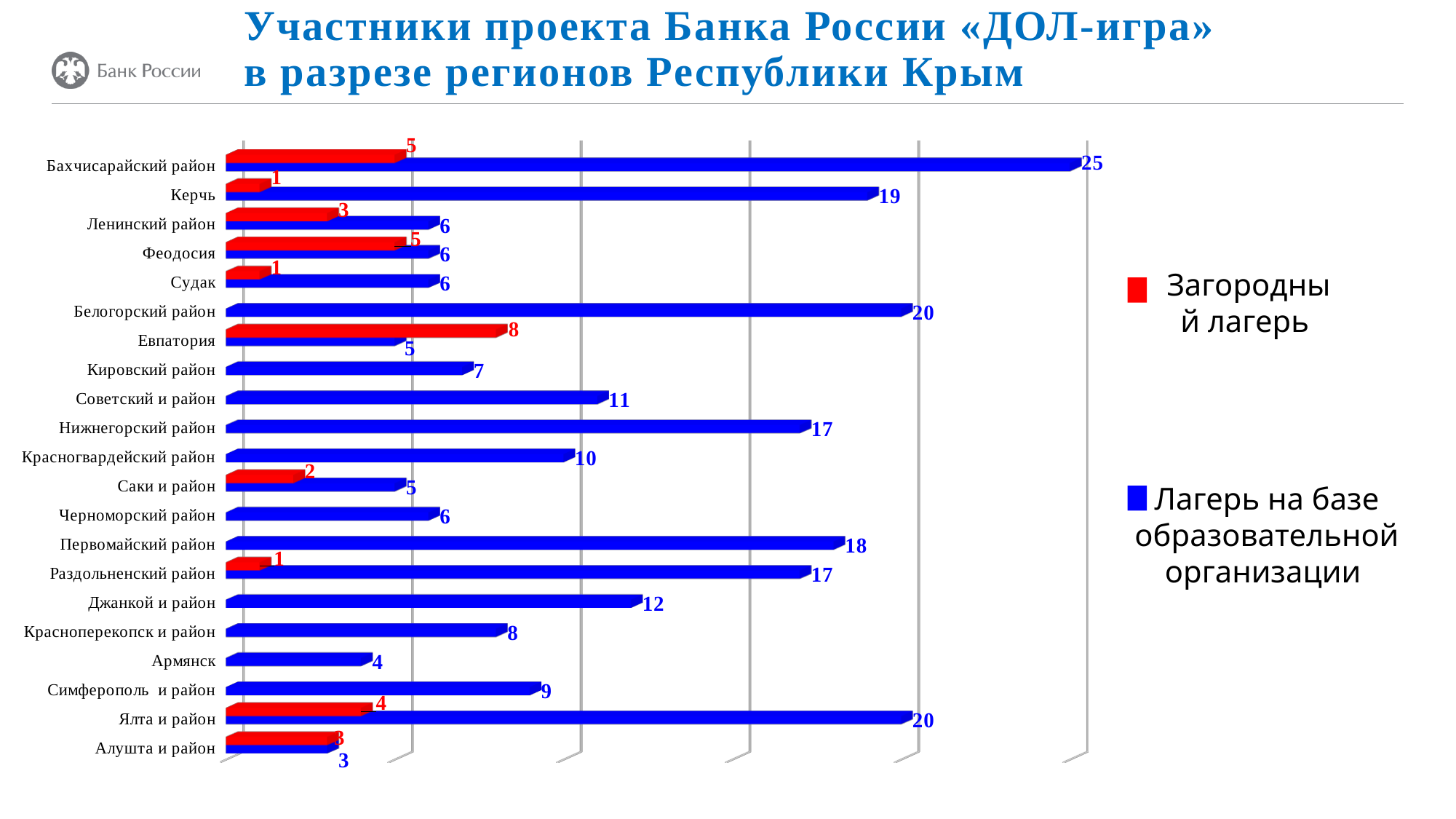
Which region has the highest value in the series «Лагерь на базе образовательной организации»? Бахчисарайский район What is the difference between the «Лагерь на базе образовательной организации» values for Керчь and Первомайский район? 1 Which colour represents the series «Загородный лагерь» in the legend? Red Which region has the highest value in the series «Загородный лагерь»? Евпатория What kind of chart is shown on the slide? Bar chart Which is larger in the series «Лагерь на базе образовательной организации»: Джанкой и район or Симферополь и район? Джанкой и район What is the value for Бахчисарайский район in the series «Лагерь на базе образовательной организации»? 25 What is the value for Нижнегорский район in the series «Лагерь на базе образовательной организации»? 17 How many series does the legend list? 2 Which region has the lowest value in the series «Лагерь на базе образовательной организации»? Алушта и район What is the value for Евпатория in the series «Загородный лагерь»? 8 How many regions (categories) are shown on the chart? 21